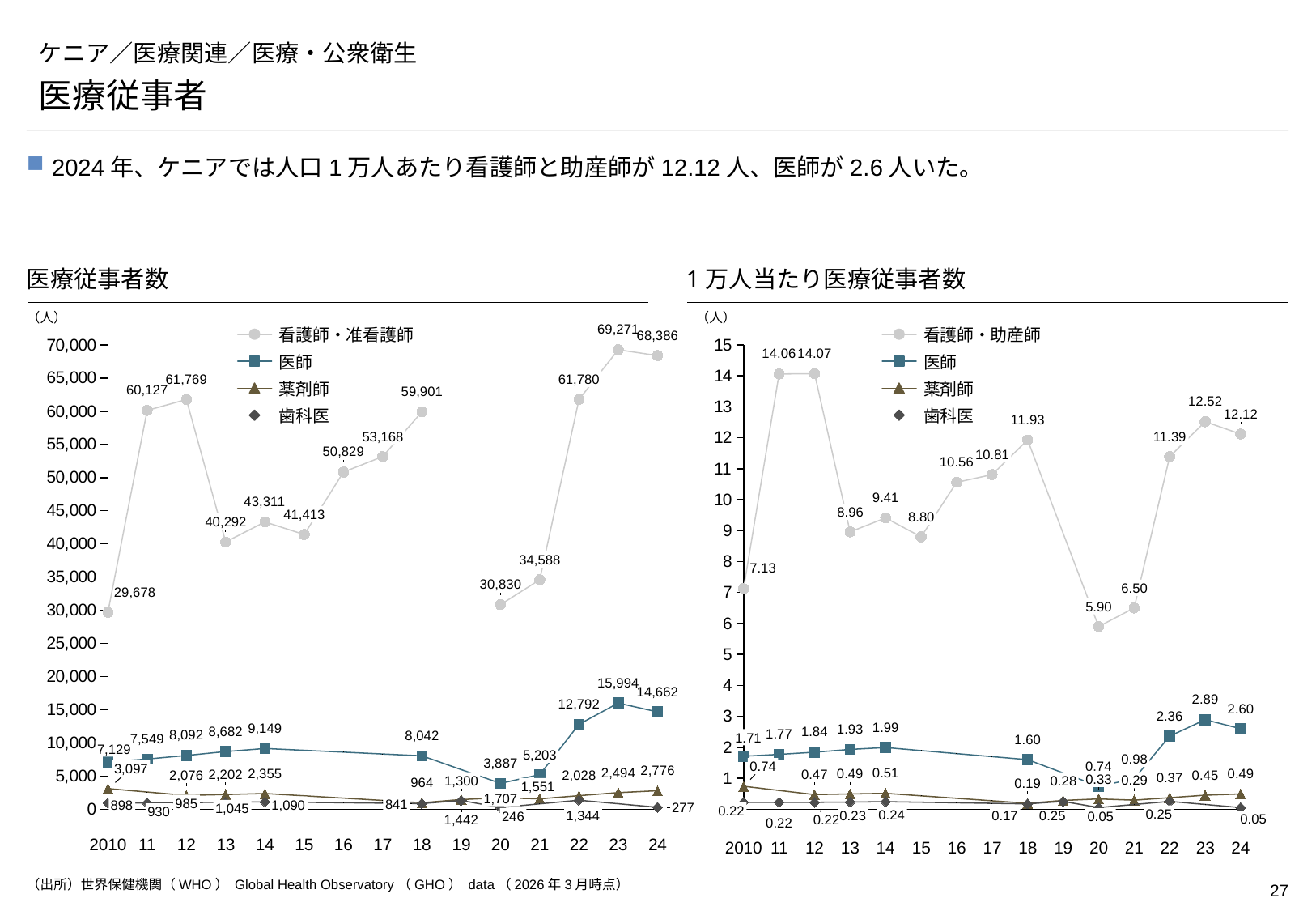
In the 医療従事者数 chart, in which year is the 看護師・准看護師 value lowest? 2010 In the 1万人当たり医療従事者数 chart, what is the value for 看護師・助産師 in 2020? 5.90 In the 医療従事者数 chart, what is the value for 看護師・准看護師 in 2023? 69,271 In the 医療従事者数 chart, which is larger: the 看護師・准看護師 value in 2012 or in 2018? 2012 In the 医療従事者数 chart, what is the value for 医師 in 2024? 14,662 In the 1万人当たり医療従事者数 chart, what is the difference between the 看護師・助産師 values in 2023 and 2024? 0.40 In the 1万人当たり医療従事者数 chart, does the 医師 value rise or fall from 2010 to 2014? Rise In the 医療従事者数 chart, what is the difference between the 医師 values in 2023 and 2022? 3,202 In the 1万人当たり医療従事者数 chart, in which year is the 医師 value highest? 2023 What kind of chart is the 1万人当たり医療従事者数 chart? Line chart How many series does the legend of the 医療従事者数 chart list? 4 In the 1万人当たり医療従事者数 chart, is the 看護師・助産師 value in 2022 greater or less than 11? greater